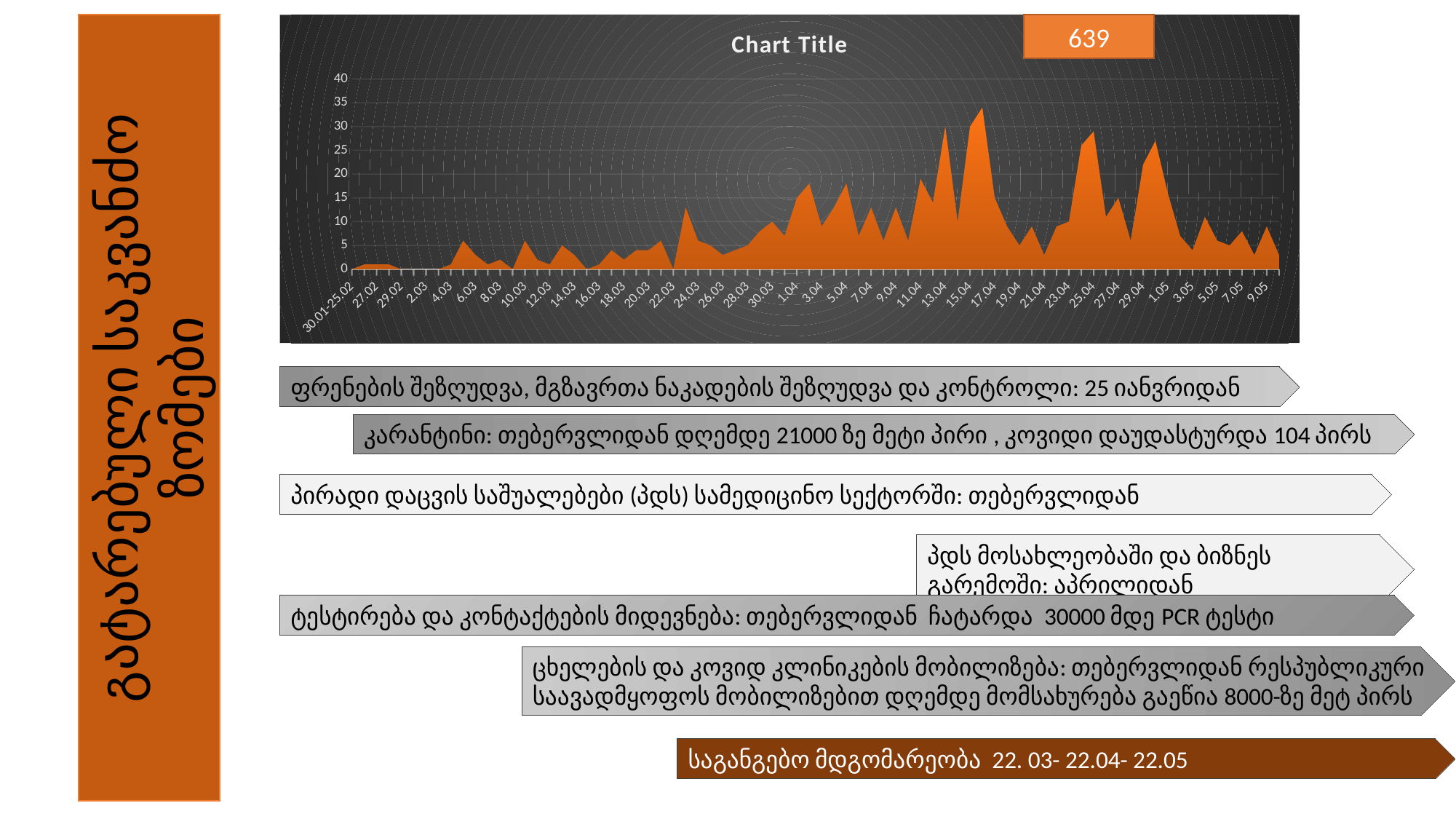
What is the highest value shown on the chart's vertical axis? 40 Is the value for 27.02 greater or less than 5? less Do the values generally rise or fall from the end of February to mid-April? rise What is the title of the chart? Chart Title Which has the larger value, 27.02 or 25.04? 25.04 What kind of chart is shown on the slide? area chart What number is shown in the orange box at the top right of the chart? 639 Is the value for 25.04 greater or less than 20? greater What is the last label on the chart's horizontal axis? 9.05 How many labels are shown on the chart's horizontal axis? 38 What is the first label on the chart's horizontal axis? 30.01-25.02 Is the highest peak on the chart greater or less than 30? greater